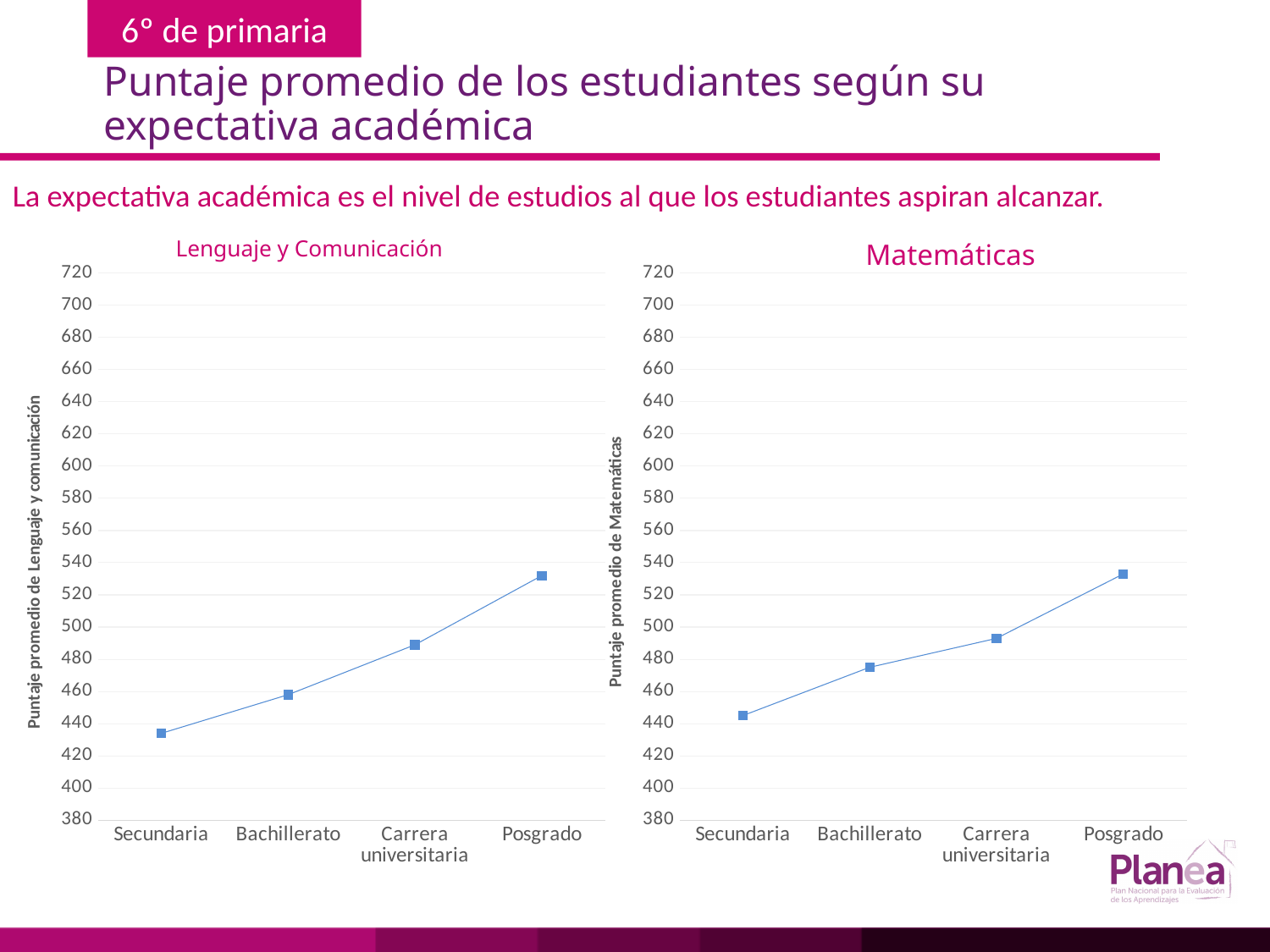
What is the y-axis label of the 'Matemáticas' chart? Puntaje promedio de Matemáticas What kind of chart is the 'Lenguaje y Comunicación' chart? line chart In the 'Lenguaje y Comunicación' chart, is the value for Secundaria greater or less than 440? less In the 'Matemáticas' chart, which category has the highest score? Posgrado In the 'Lenguaje y Comunicación' chart, which category has the lowest score? Secundaria In the 'Matemáticas' chart, which category has the lowest score? Secundaria In the 'Matemáticas' chart, which is larger, the value for Carrera universitaria or the value for Bachillerato? Carrera universitaria In the 'Lenguaje y Comunicación' chart, is the value for Posgrado greater or less than 520? greater In the 'Matemáticas' chart, is the value for Bachillerato greater or less than 460? greater In the 'Lenguaje y Comunicación' chart, which category has the highest score? Posgrado In the 'Matemáticas' chart, do the values rise or fall from Secundaria to Posgrado? rise How many categories are shown on the x axis of the 'Matemáticas' chart? 4